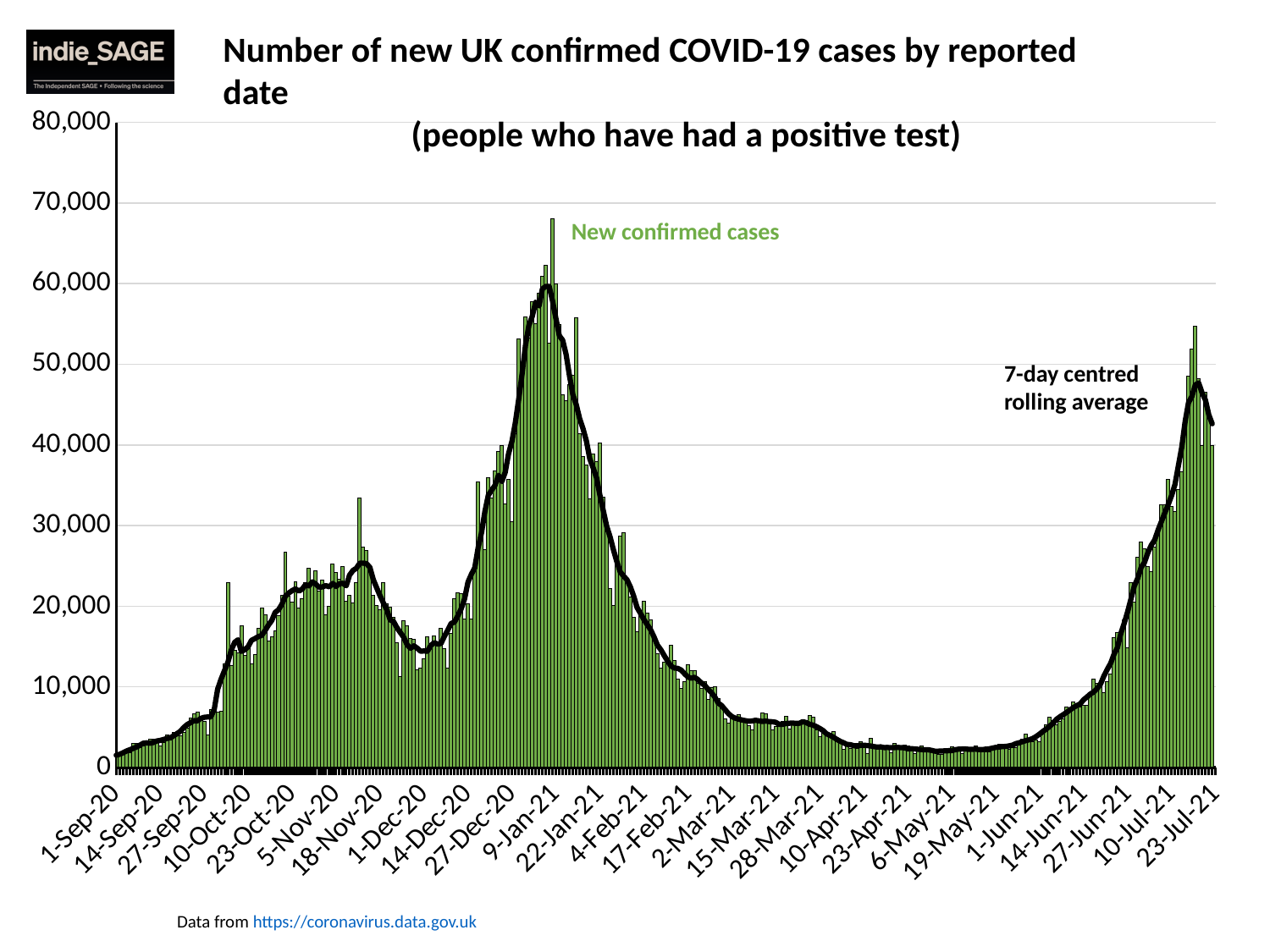
Between 1-Sep-20 and 5-Nov-20, does the 7-day centred rolling average rise or fall? rise Is the 7-day centred rolling average around 9-Jan-21 greater or less than 50,000? greater Which peak of the 7-day centred rolling average is higher: the one in November 2020 or the one in January 2021? January 2021 What is the data source cited below the chart? https://coronavirus.data.gov.uk Is the highest single-day bar for new confirmed cases greater or less than 60,000? greater What is the title of the chart? Number of new UK confirmed COVID-19 cases by reported date (people who have had a positive test) Between 9-Jan-21 and 2-Mar-21, does the 7-day centred rolling average rise or fall? fall How many data series are shown on the chart? 2 Near which x-axis date label does the highest peak of new confirmed cases occur? 9-Jan-21 What kind of chart is shown on the slide? combination bar and line chart Is the 7-day centred rolling average around 6-May-21 greater or less than 10,000? less